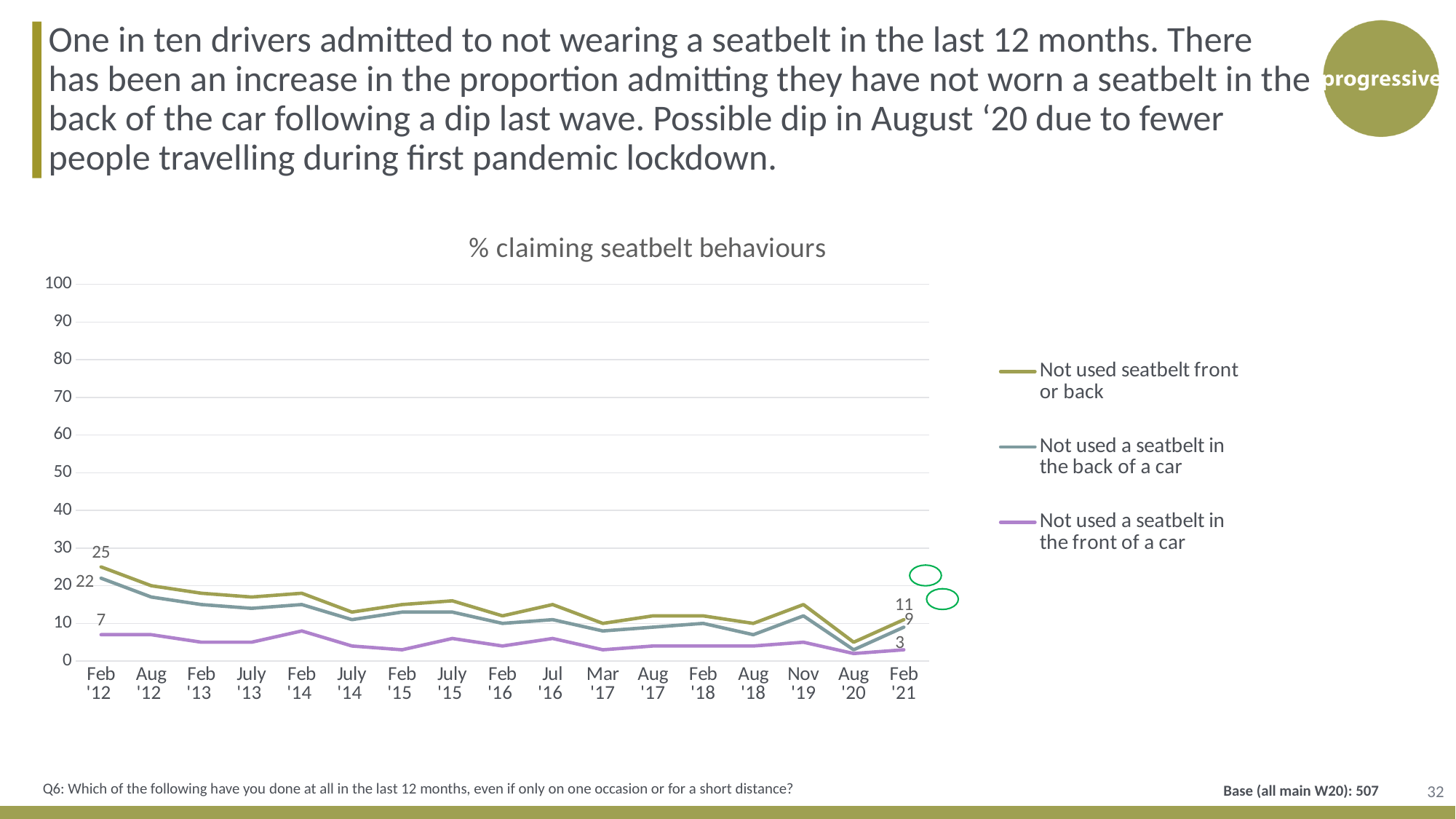
In Feb '21, which is larger: 'Not used a seatbelt in the back of a car' or 'Not used a seatbelt in the front of a car'? Not used a seatbelt in the back of a car How many series does the legend list? 3 Which series has the highest value in Feb '21? Not used seatbelt front or back What is the value for 'Not used a seatbelt in the back of a car' in Feb '21? 9 What kind of chart is shown on the slide? line chart What is the value for 'Not used a seatbelt in the front of a car' in Feb '12? 7 What is the title of the chart? % claiming seatbelt behaviours Is the value for 'Not used seatbelt front or back' in Aug '20 greater or less than 10? less How many time points are shown on the x axis? 17 Does the 'Not used seatbelt front or back' line overall rise or fall from Feb '12 to Feb '21? fall What is the value for 'Not used seatbelt front or back' in Feb '12? 25 By how much did the value for 'Not used seatbelt front or back' fall between Feb '12 and Feb '21? 14